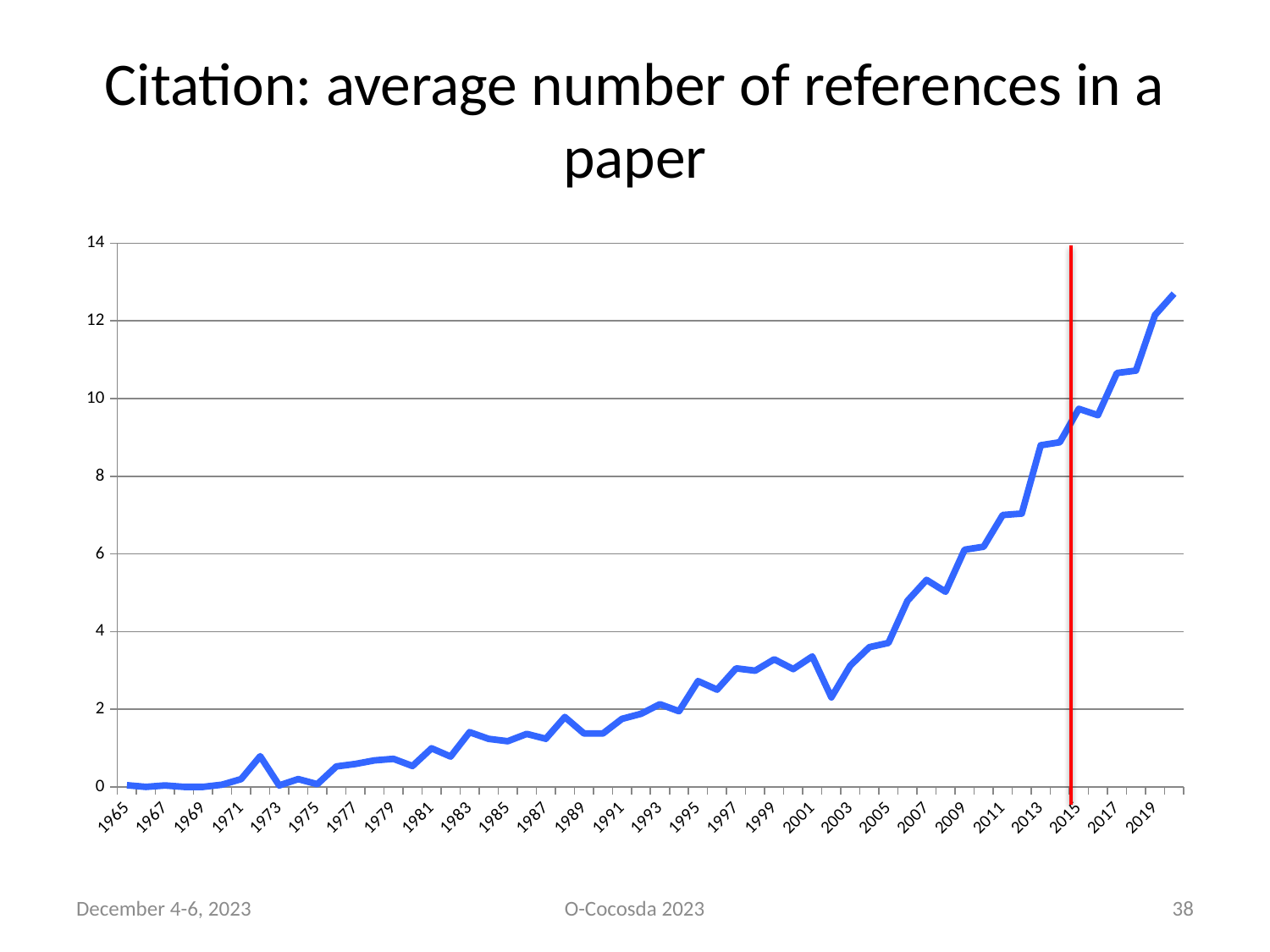
What kind of chart is shown on the slide? line chart Which year has the larger value, 2005 or 2013? 2013 Is the value for 2017 greater or less than 10? greater Is the value for 2013 greater or less than 8? greater Which year has the larger value, 1989 or 1999? 1999 Overall, do the values rise or fall from 1965 to the end of the series? rise Is the value for 2005 greater or less than 4? less What is the title of the chart on the slide? Citation: average number of references in a paper At which year is the red vertical line drawn on the chart? 2015